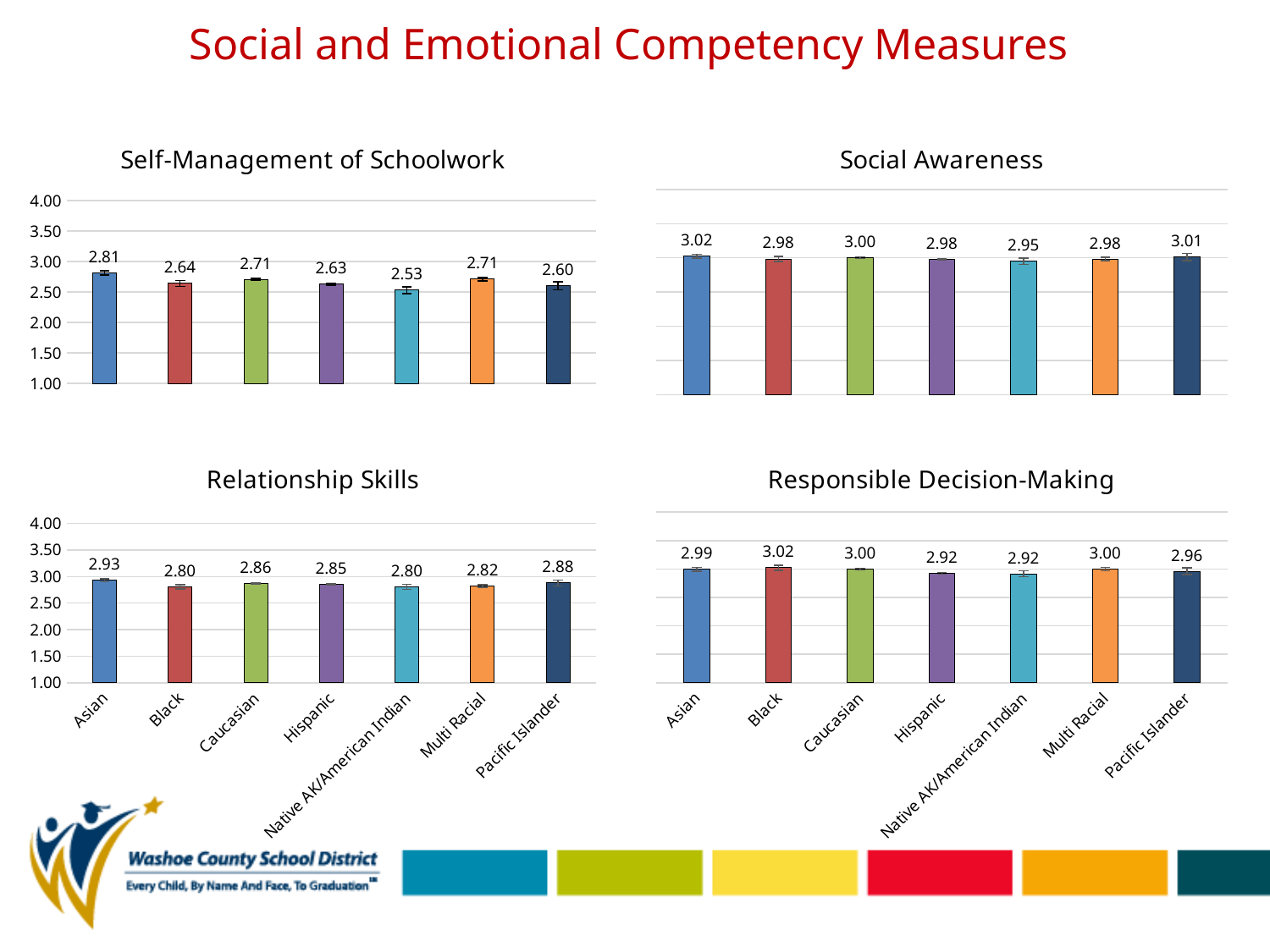
In the Responsible Decision-Making chart, what is the value for Pacific Islander? 2.96 In the Social Awareness chart, what is the lowest value shown? 2.95 In the Relationship Skills chart, which category has the highest value? Asian In the Social Awareness chart, what is the value shown on the third bar from the left? 3.00 In the Relationship Skills chart, what is the value for Hispanic? 2.85 In the Self-Management of Schoolwork chart, what is the highest value shown? 2.81 In the Responsible Decision-Making chart, which category has the highest value? Black In the Responsible Decision-Making chart, which is larger, the value for Caucasian or the value for Hispanic? Caucasian In the Relationship Skills chart, what is the difference between the values for Asian and Black? 0.13 What type of chart is the Responsible Decision-Making chart? Bar chart How many categories are shown in the Relationship Skills chart? 7 In the Self-Management of Schoolwork chart, what is the lowest value shown? 2.53